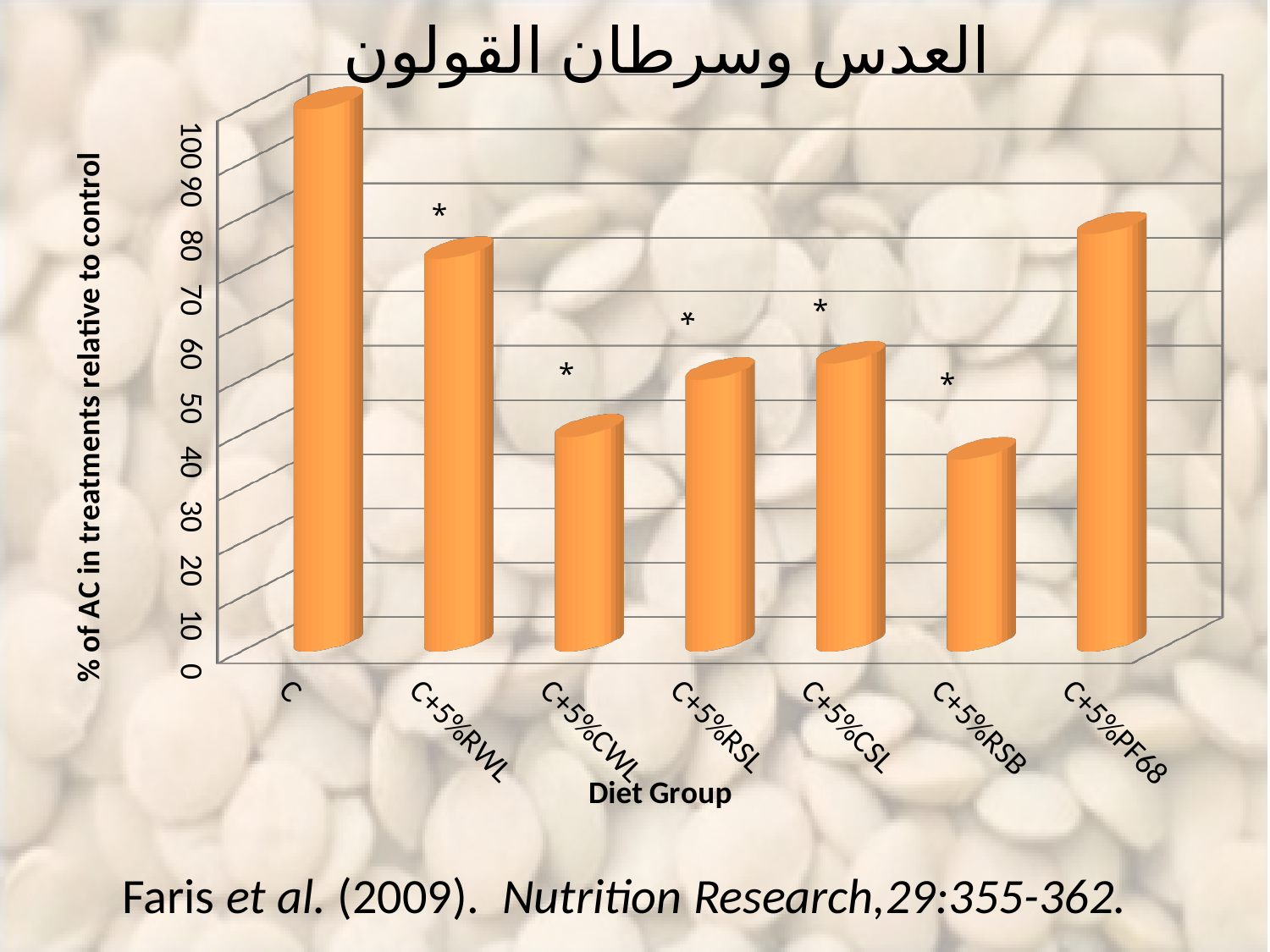
Is the value for C+5%RWL greater or less than 70? greater Which is larger, the value for C+5%PF68 or the value for C+5%CSL? C+5%PF68 What is the title of the y axis of the chart? % of AC in treatments relative to control Which is larger, the value for C+5%RWL or the value for C+5%CWL? C+5%RWL What is the title of the x axis of the chart? Diet Group Is the value for C+5%RSL greater or less than 60? less Is the value for C+5%PF68 greater or less than 70? greater Which diet group has the highest value in the chart? C How many diet groups are shown on the x axis of the chart? 7 What kind of chart is shown on the slide? bar chart